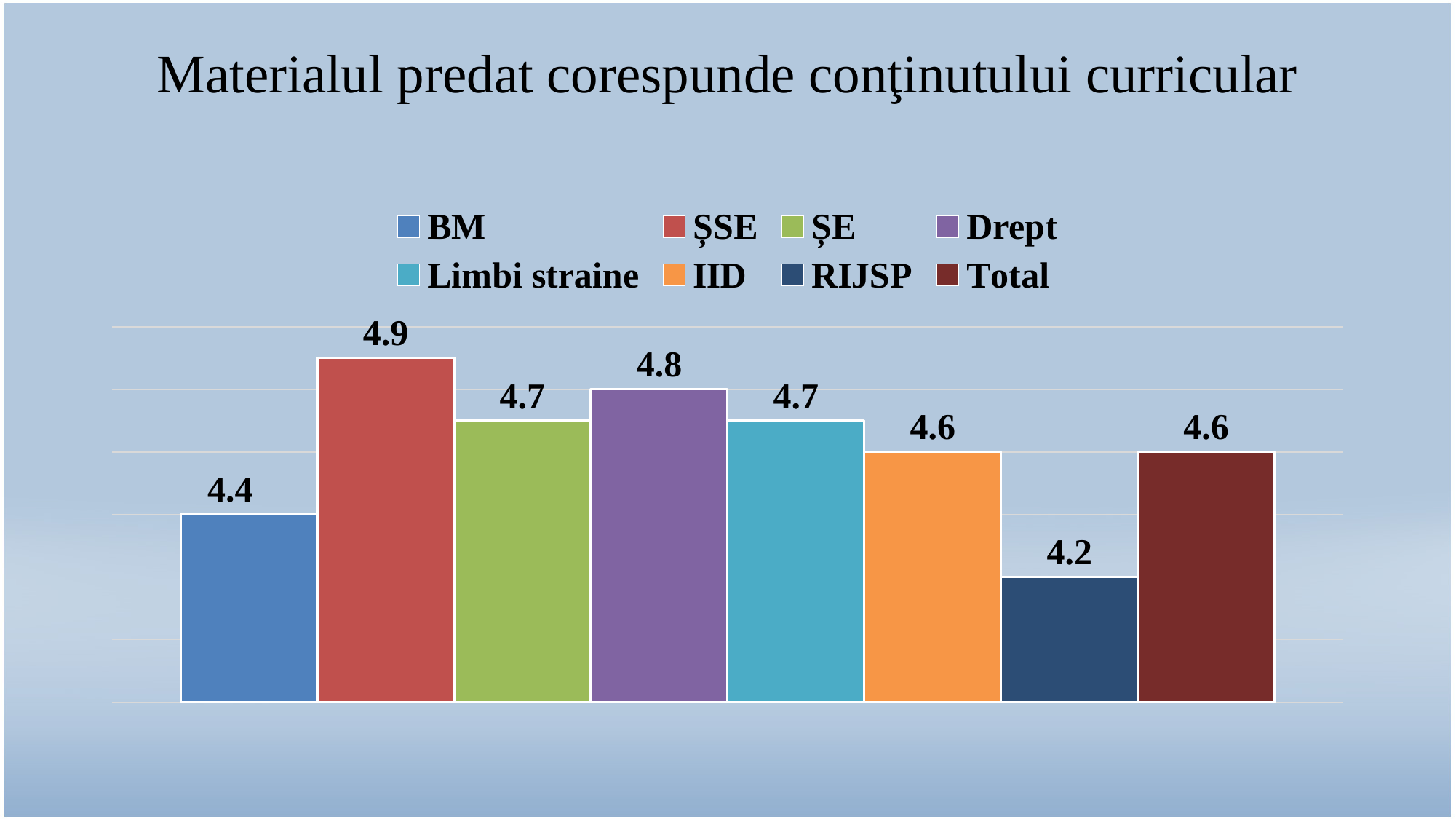
What is the value for Drept? 4.8 What is the value for RIJSP? 4.2 What kind of chart is shown on the slide? Bar chart Which is larger, the value for Drept or the value for IID? Drept Which series has the lowest value? RIJSP Which series has the highest value? ȘSE What is the title of the chart? Materialul predat corespunde conţinutului curricular How many series does the legend list? 8 What is the value for Total? 4.6 What is the value for BM? 4.4 What is the value for ȘSE? 4.9 What is the difference between the values for ȘSE and RIJSP? 0.7